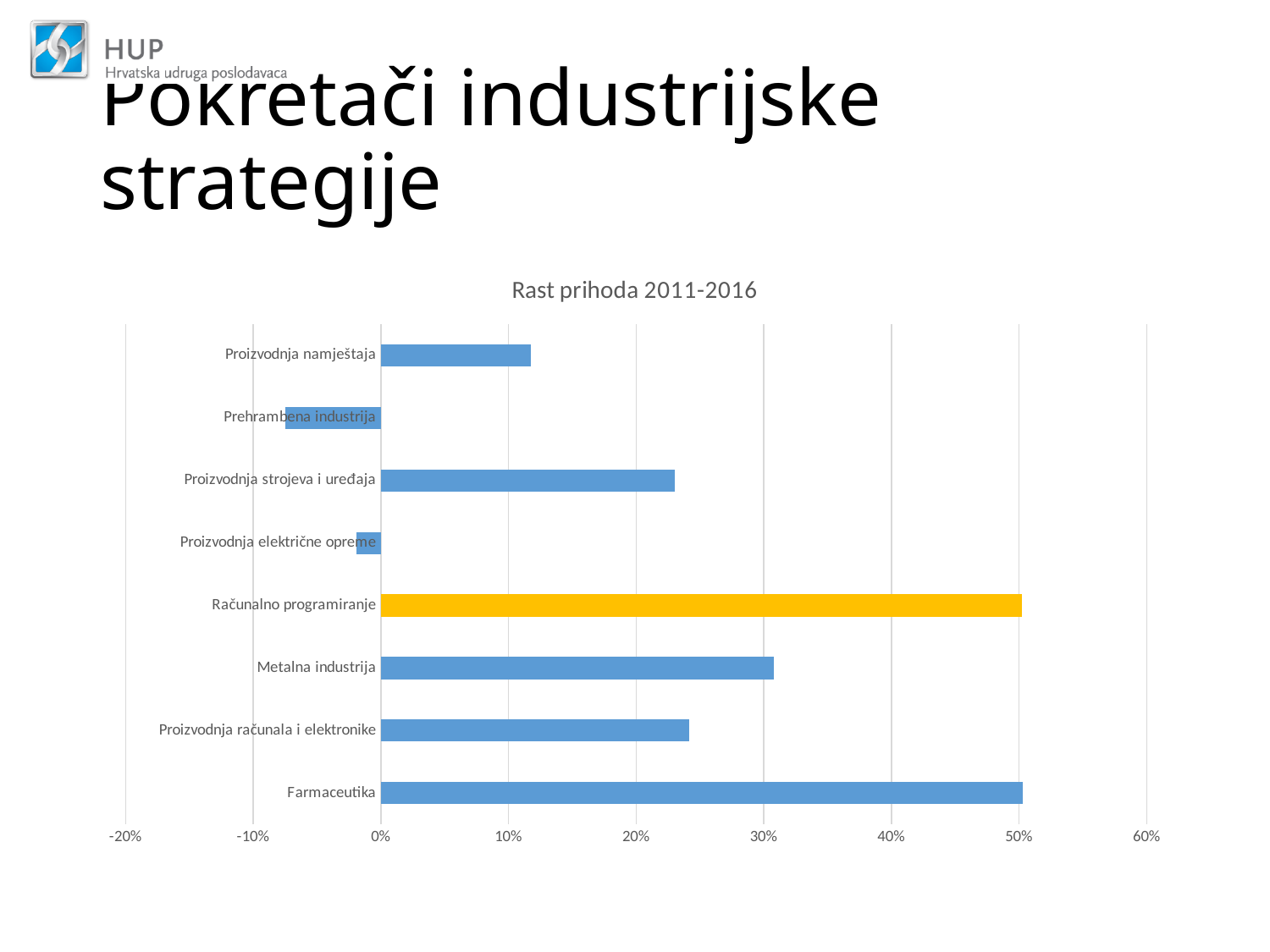
Is the value for Proizvodnja strojeva i uređaja greater or less than 20%? greater Which category has the lowest value in the chart? Prehrambena industrija Which category's bar is highlighted in yellow rather than blue? Računalno programiranje What kind of chart is shown on the slide? bar chart Is the value for Farmaceutika greater or less than 40%? greater Is the value for Proizvodnja namještaja greater or less than 20%? less Which is larger, the value for Proizvodnja računala i elektronike or the value for Proizvodnja namještaja? Proizvodnja računala i elektronike How many categories are plotted in the chart? 8 Which is larger, the value for Metalna industrija or the value for Proizvodnja strojeva i uređaja? Metalna industrija What is the title of the chart? Rast prihoda 2011-2016